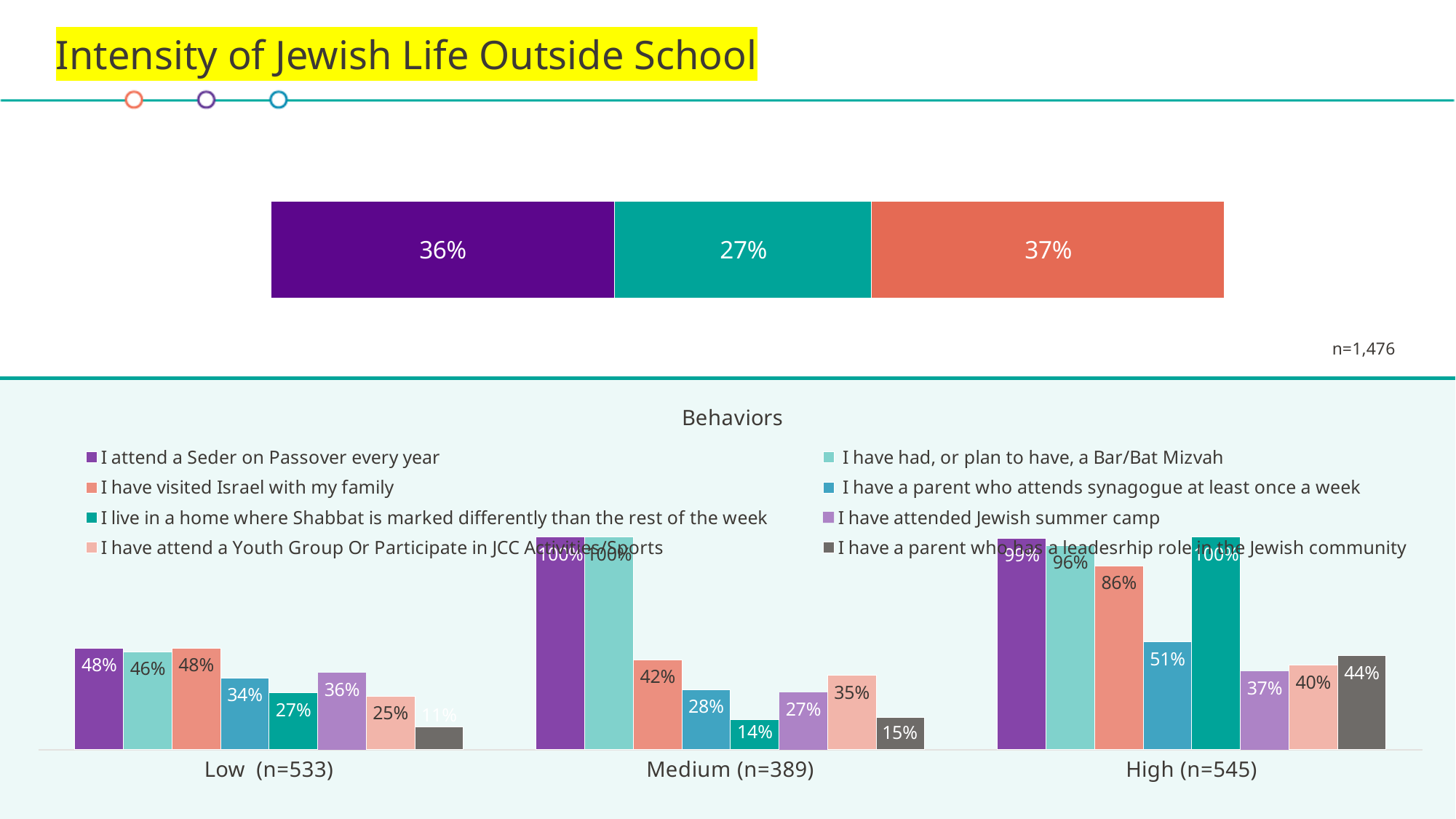
In the Behaviors chart, what percentage of the Medium group lives in a home where Shabbat is marked differently than the rest of the week? 14% In the Behaviors chart, what percentage of the Low group has visited Israel with their family? 48% In the Behaviors chart, what is the difference between the High and Low groups for 'I have visited Israel with my family'? 38 percentage points What kind of chart is the Behaviors chart? Bar chart How many groups (categories) are shown along the x axis of the Behaviors chart? 3 In the Behaviors chart, which behavior has the lowest value in the Low group? I have a parent who has a leadesrhip role in the Jewish community How many series does the legend of the Behaviors chart list? 8 In the stacked bar at the top of the slide, what value is shown in the middle (teal) segment? 27% In the Behaviors chart, which behavior has the highest value in the High group? I live in a home where Shabbat is marked differently than the rest of the week In the Behaviors chart, is the value for 'I have attended Jewish summer camp' larger in the Low group or the Medium group? Low group In the Behaviors chart, what percentage of the High group has a parent who attends synagogue at least once a week? 51% What is the total of the three segments in the stacked bar at the top of the slide? 100%